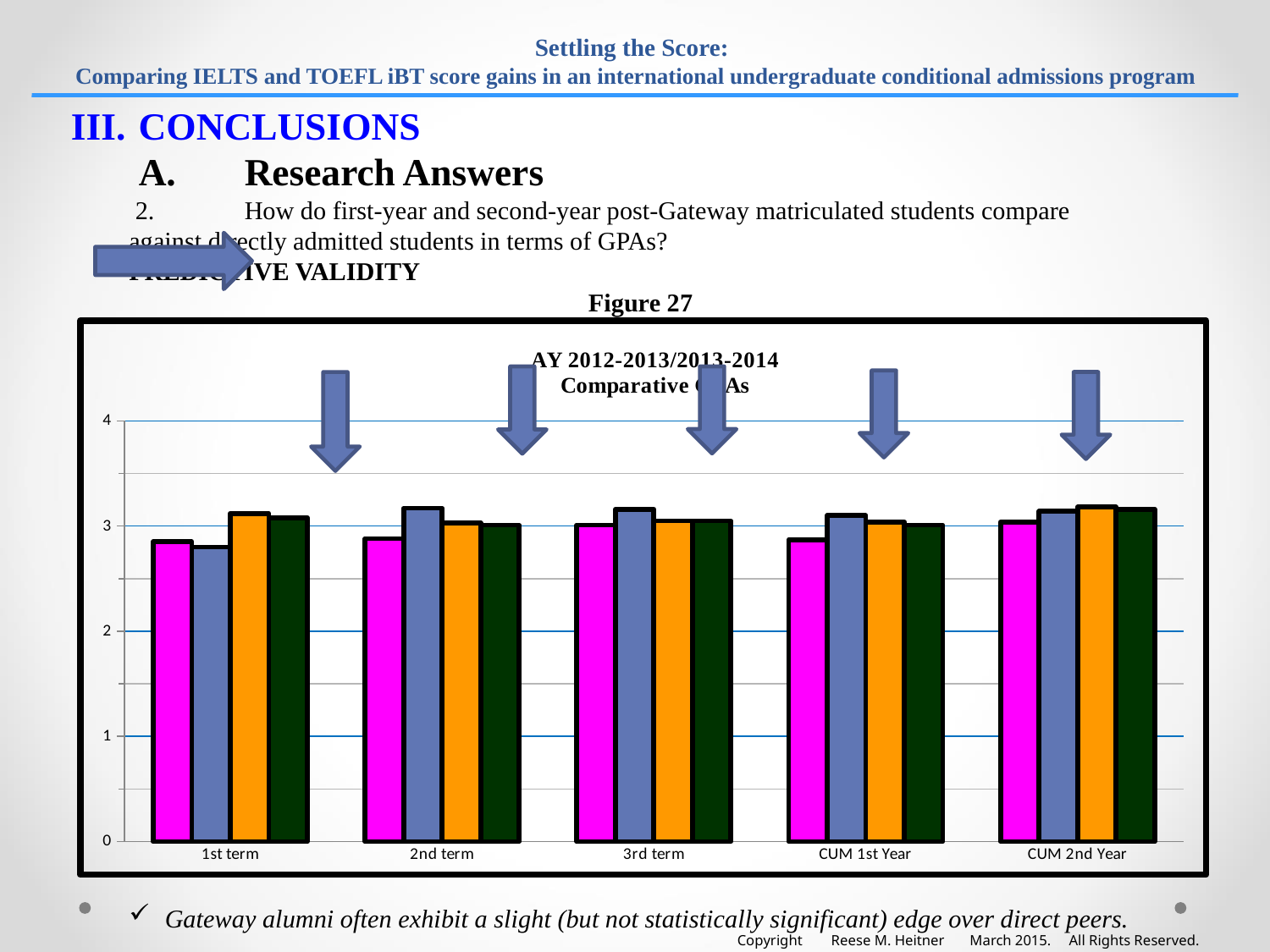
Which is larger: the magenta bar for 1st term or the blue bar for 2nd term? the blue bar for 2nd term How many bars are plotted for each category on the chart? 4 Is the value of the magenta bar for 1st term greater or less than 3? less What kind of chart is shown in Figure 27? bar chart Is the value of the magenta bar for CUM 1st Year greater or less than 3? less Is the value of the orange bar for 1st term greater or less than 3? greater How many categories are shown along the x axis of the chart? 5 Which coloured bar is the highest in the 2nd term category? blue What is the title printed above the chart's plot area? AY 2012-2013/2013-2014 Comparative GPAs What figure number is given to the chart on the slide? Figure 27